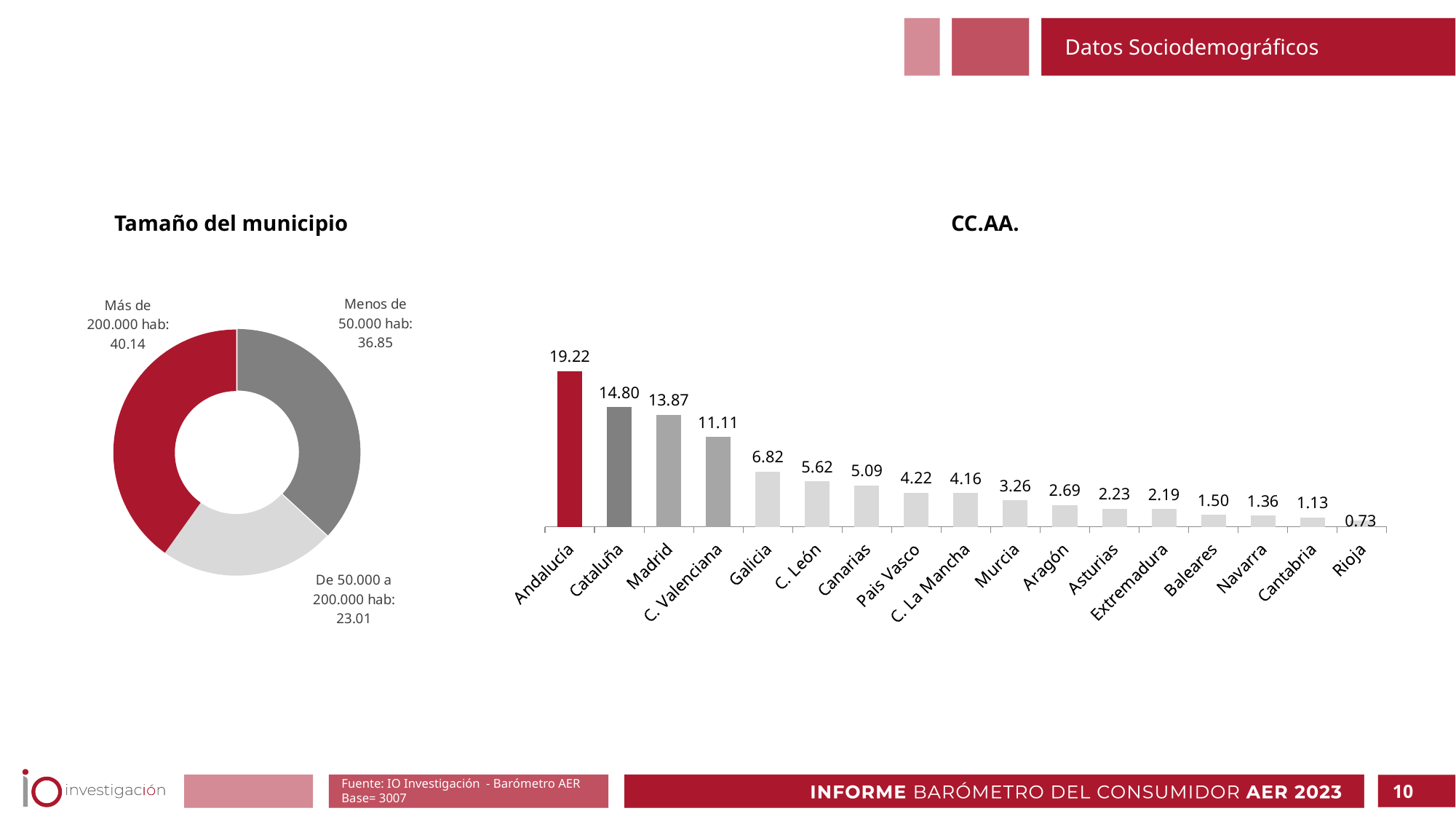
In the 'Tamaño del municipio' chart, what is the difference between 'Más de 200.000 hab' and 'Menos de 50.000 hab'? 3.29 In the 'CC.AA.' chart, what is the value for Madrid? 13.87 What kind of chart is 'Tamaño del municipio'? Doughnut chart What kind of chart is 'CC.AA.'? Bar chart In the 'Tamaño del municipio' chart, what is the value for 'Más de 200.000 hab'? 40.14 In the 'CC.AA.' chart, which region has the highest value? Andalucía In the 'CC.AA.' chart, which is larger, Galicia or C. León? Galicia In the 'CC.AA.' chart, what is the difference between Andalucía and Cataluña? 4.42 How many categories does the 'Tamaño del municipio' chart show? 3 In the 'CC.AA.' chart, which region has the lowest value? Rioja In the 'Tamaño del municipio' chart, which category has the smallest share? De 50.000 a 200.000 hab How many regions are shown in the 'CC.AA.' chart? 17